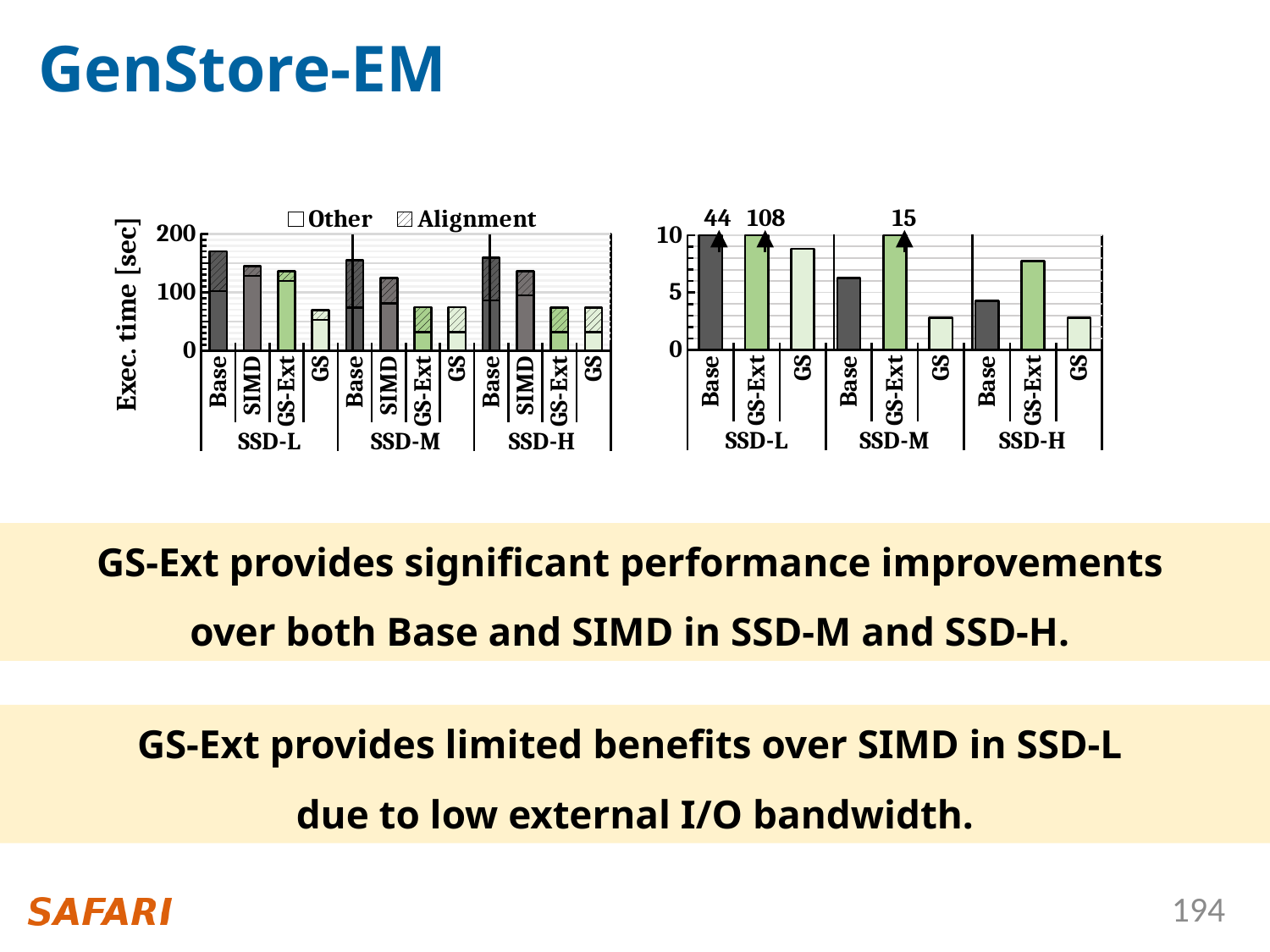
On the left chart, is the total value for Base in SSD-L greater or less than 100? greater On the left chart, how many series does the legend list? 2 On the right chart, what is the labeled value for GS-Ext in SSD-L? 108 On the left chart, is the total value for GS in SSD-L greater or less than 100? less On the left chart, what are the two legend entries? Other and Alignment What kind of chart is the left chart? Stacked bar chart On the right chart, what is the difference between the labeled values for GS-Ext and Base in SSD-L? 64 On the left chart, within the SSD-L group, which configuration has the highest total execution time? Base On the right chart, is the value for GS in SSD-M greater or less than 5? less On the left chart, what is the y-axis label? Exec. time [sec] On the right chart, what is the labeled value for Base in SSD-L? 44